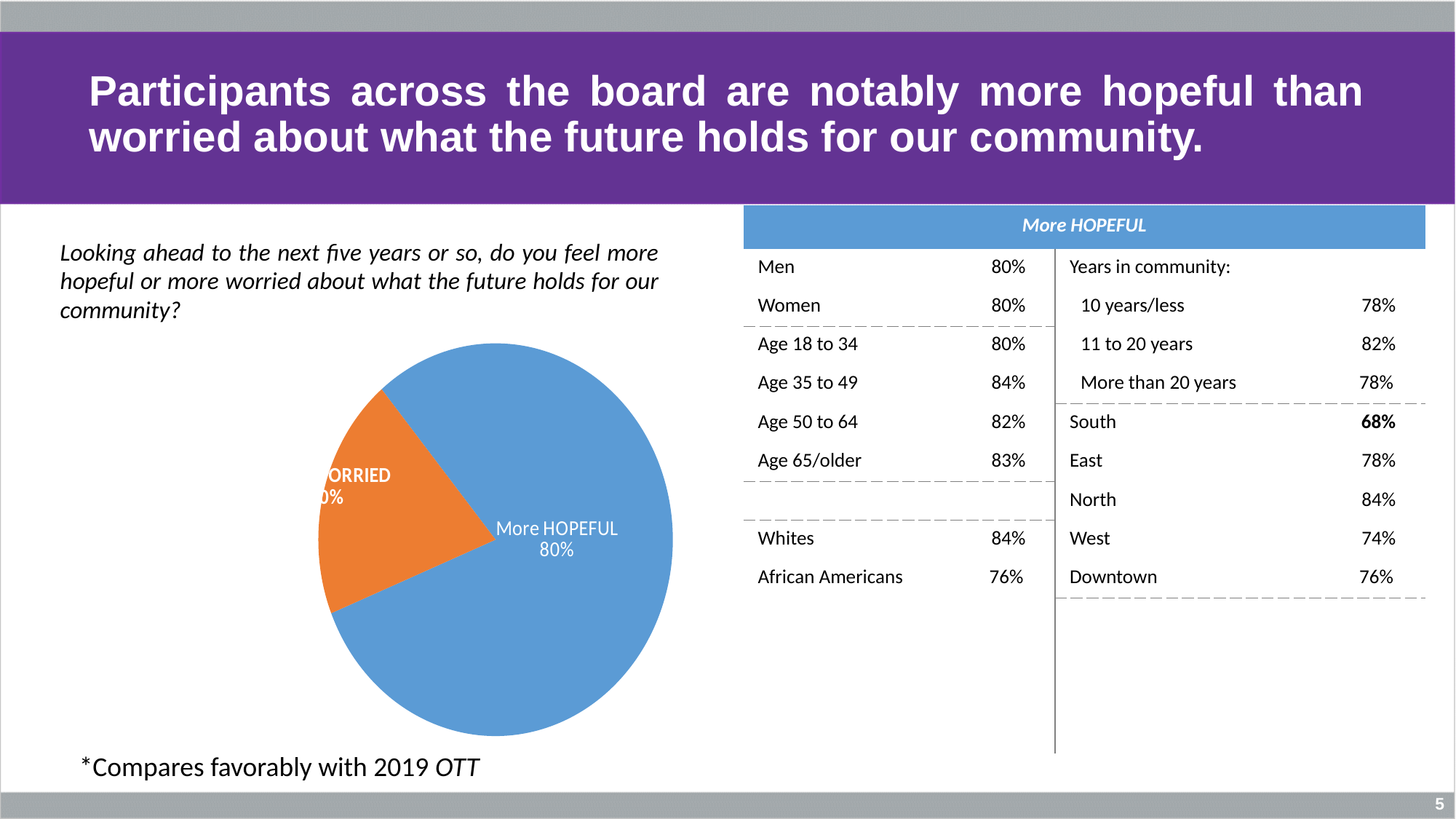
Which is larger in the pie chart, the More HOPEFUL slice or the worried slice? More HOPEFUL How many slices does the pie chart have? 2 What colour is the smaller slice of the pie chart? orange What colour is the More HOPEFUL slice in the pie chart? blue What percentage of participants are More HOPEFUL according to the pie chart? 80% Which slice of the pie chart is the largest? More HOPEFUL What share of the pie does the More HOPEFUL slice represent? 80% What kind of chart is shown on the slide? pie chart